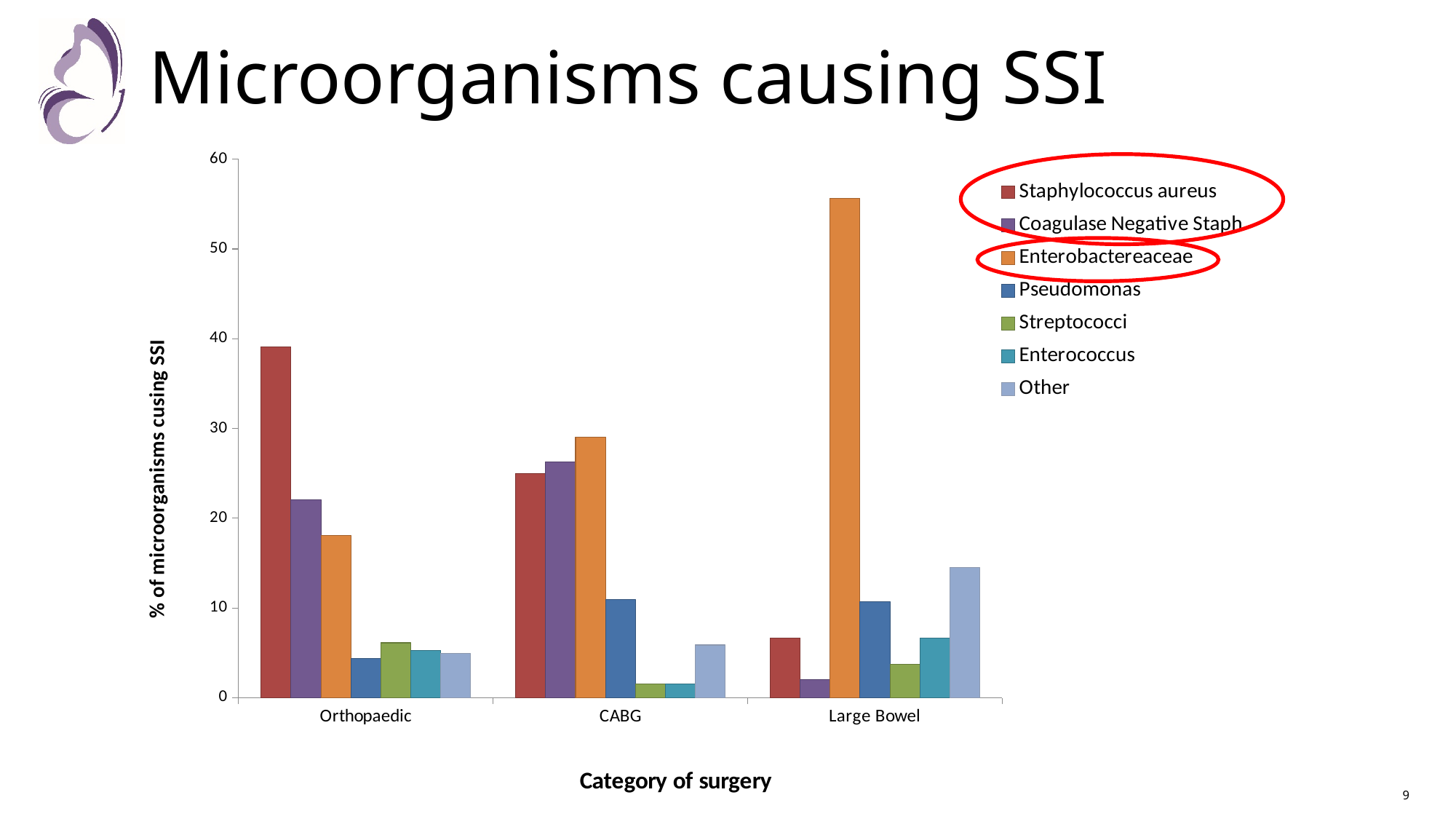
In Large Bowel surgery, which is larger, the value for Other or the value for Pseudomonas? Other Which microorganism has the lowest percentage for Large Bowel surgery? Coagulase Negative Staph Is the value for Enterobactereaceae in CABG surgery greater or less than 20? greater Is the value for Enterobactereaceae in Large Bowel surgery greater or less than 50? greater Is the value for Staphylococcus aureus in Orthopaedic surgery greater or less than 30? greater How many categories of surgery are shown on the x axis? 3 What kind of chart is shown on the slide? Bar chart Which microorganism has the highest percentage for Large Bowel surgery? Enterobactereaceae Which microorganism has the highest percentage for Orthopaedic surgery? Staphylococcus aureus Which category has the larger value for Staphylococcus aureus, Orthopaedic or CABG? Orthopaedic How many series does the legend list? 7 What is the title of the y axis? % of microorganisms cusing SSI